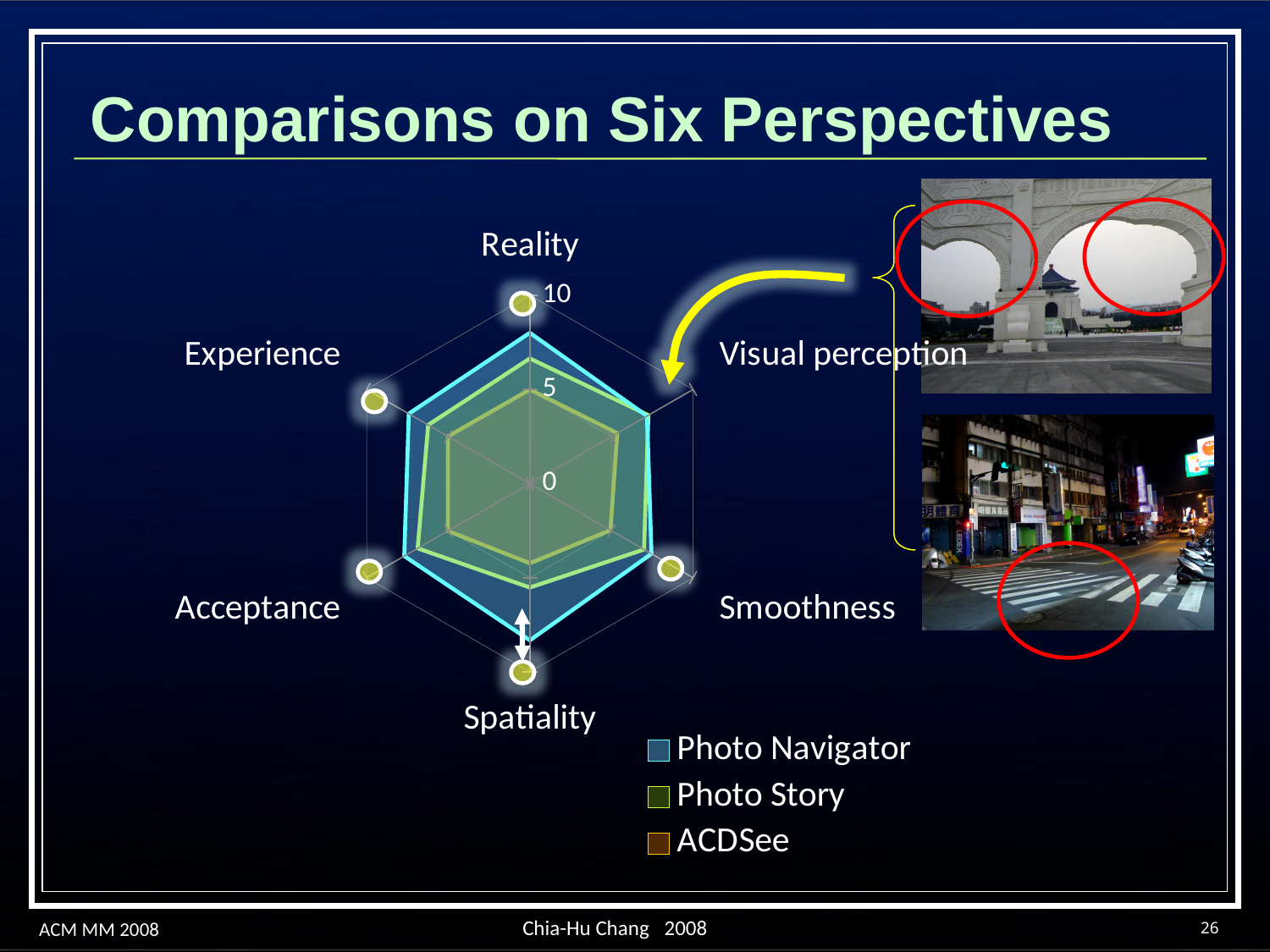
What is the title of the slide containing the chart? Comparisons on Six Perspectives How many series does the legend list? 3 Is the ACDSee value for Smoothness greater or less than 10? less Which series has the smallest value for Reality? ACDSee What kind of chart is shown on the slide? Radar chart Is the Photo Navigator value for Spatiality greater or less than 5? greater Is the Photo Story value for Reality greater or less than 5? greater What is the maximum value shown on the radar chart's axis scale? 10 Which series are listed in the chart legend? Photo Navigator, Photo Story, ACDSee Which is larger on the Acceptance axis, Photo Navigator or ACDSee? Photo Navigator Which series has the largest value for Spatiality? Photo Navigator How many perspectives (axes) does the radar chart have? 6